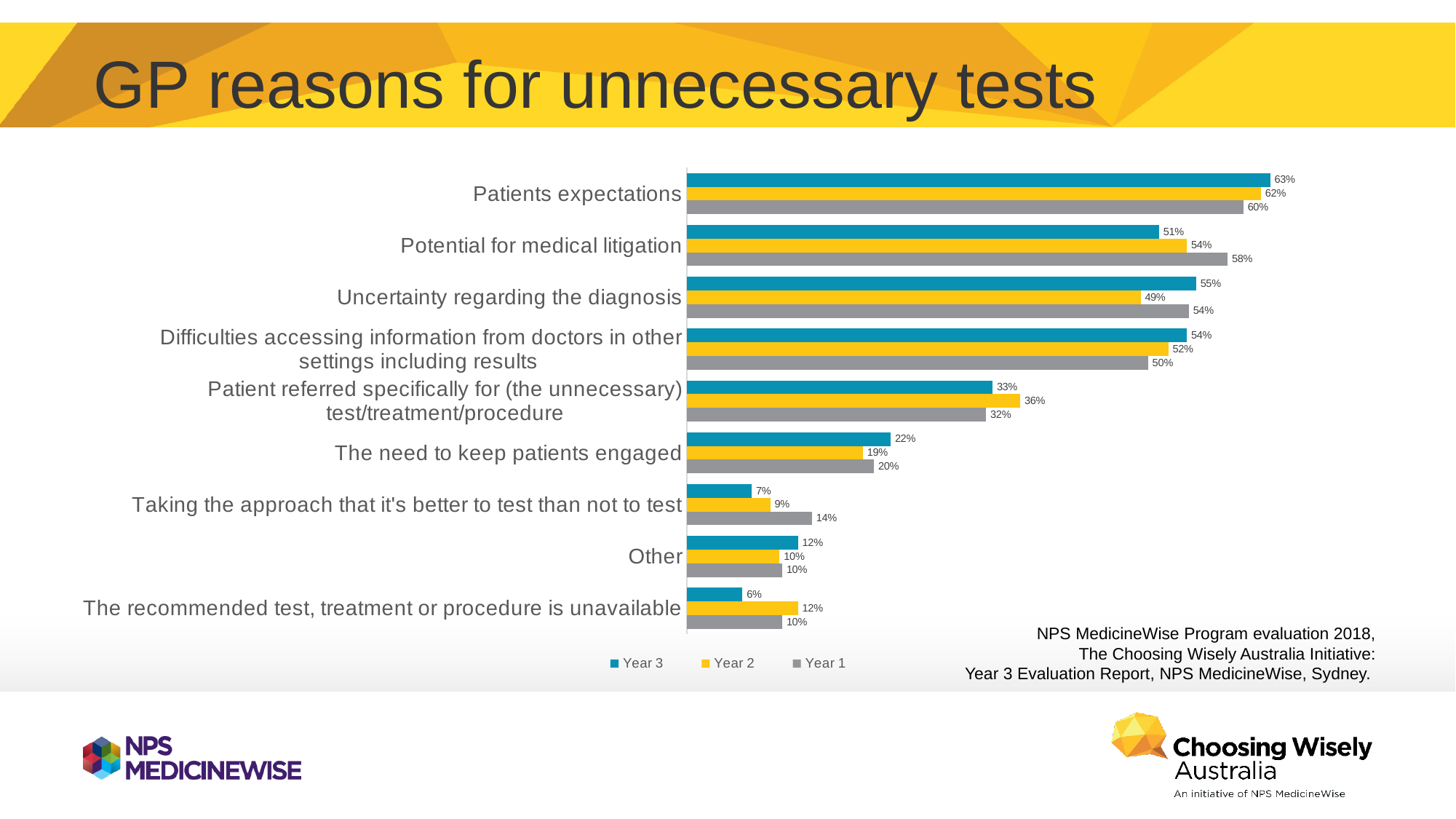
How many categories are shown on the chart? 9 Which category has the lowest Year 3 value? The recommended test, treatment or procedure is unavailable Which category has the highest Year 3 value? Patients expectations What is the Year 1 value for Potential for medical litigation? 58% What is the Year 2 value for Uncertainty regarding the diagnosis? 49% What kind of chart is shown on the slide? Bar chart How many series does the legend list? 3 What is the Year 1 value for Taking the approach that it's better to test than not to test? 14% What is the Year 3 value for Patients expectations? 63% What is the difference between the Year 3 and Year 1 values for Patients expectations? 3% What is the difference between the Year 1 and Year 3 values for Potential for medical litigation? 7% For The need to keep patients engaged, which is larger: the Year 3 value or the Year 2 value? Year 3